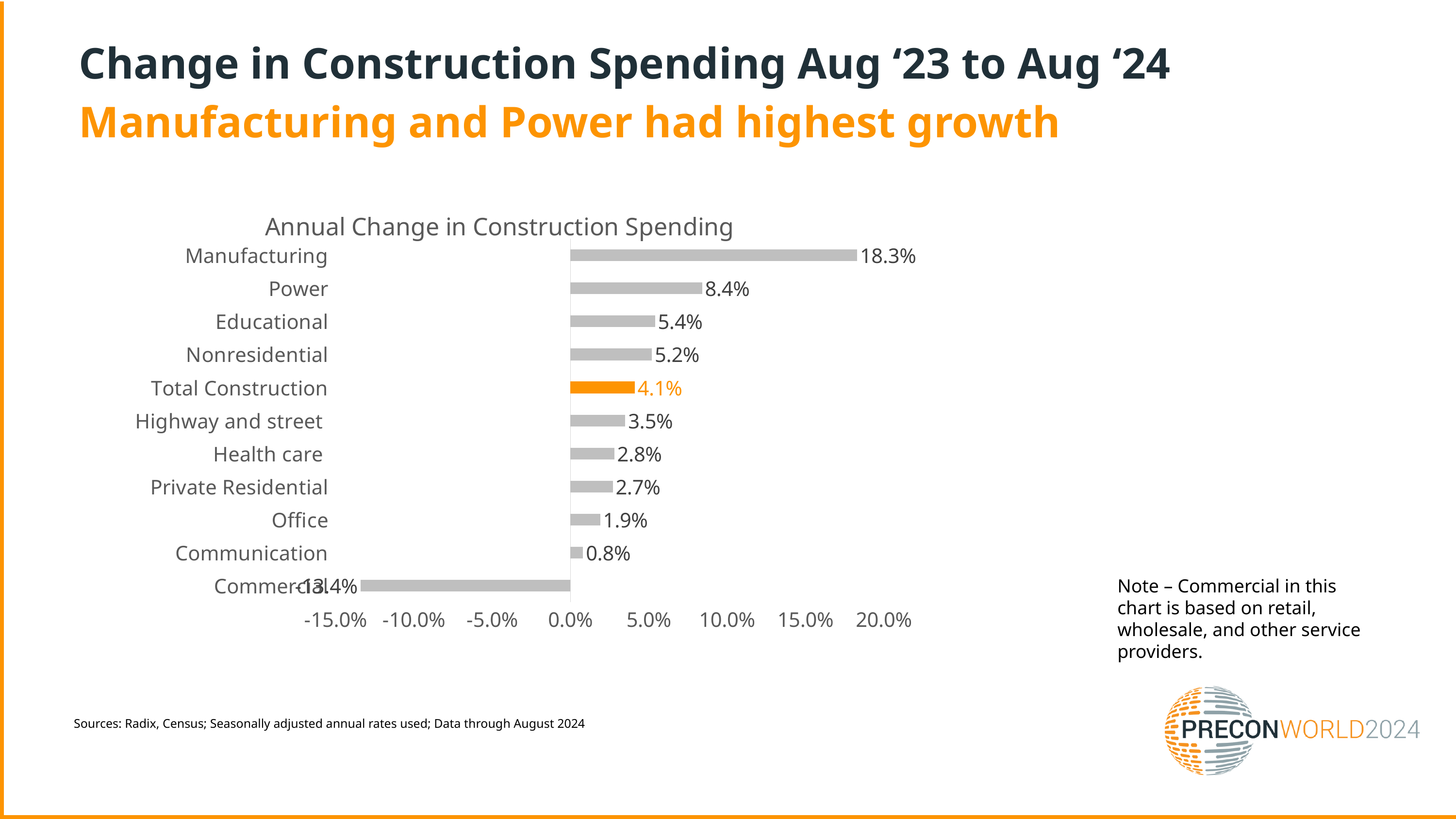
What is the title of the chart? Annual Change in Construction Spending Which category has the highest value? Manufacturing Which is larger, the value for Educational or the value for Nonresidential? Educational Which category has the lowest value? Commercial What is the value for Communication? 0.8% Is the value for Power greater or less than 10.0%? less What is the value for Manufacturing? 18.3% What is the value for Power? 8.4% What kind of chart is shown on the slide? Bar chart How many categories are shown in the chart? 11 What is the difference between the values for Manufacturing and Power? 9.9% What is the value for Total Construction? 4.1%